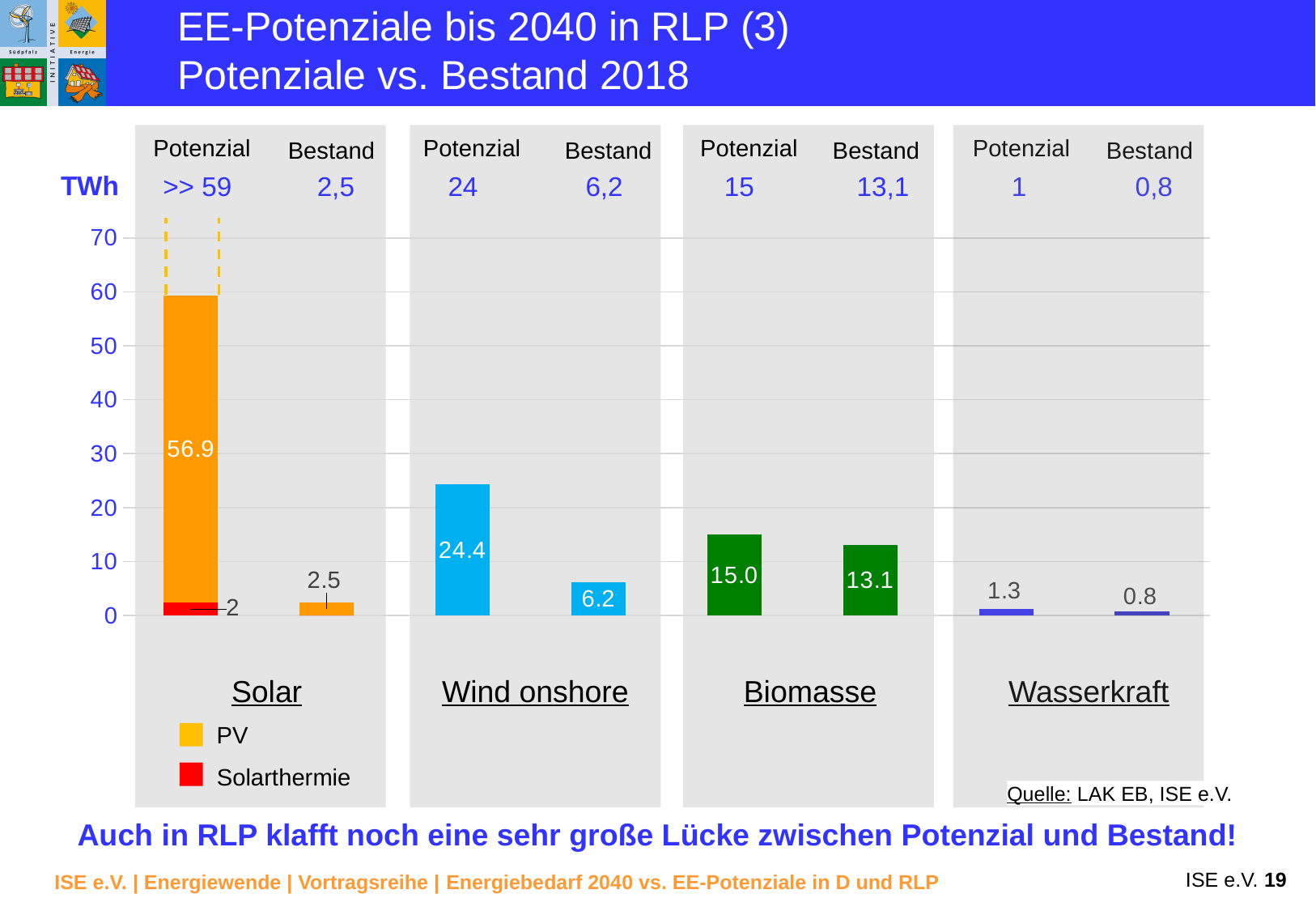
What is the difference between the Potenzial and Bestand data labels for Wind onshore? 18.2 What is the data label on the Potenzial bar for Wind onshore? 24.4 Which energy source has the highest Potenzial bar? Solar Which energy source has the lowest Bestand bar? Wasserkraft What is the data label on the PV segment of the Solar Potenzial bar? 56.9 Which is larger for Biomasse, the Potenzial bar or the Bestand bar? Potenzial What kind of chart is shown on the slide? bar chart What is the data label on the Solarthermie segment of the Solar Potenzial bar? 2 What is the data label on the Bestand bar for Biomasse? 13.1 How many energy source categories are shown in the chart? 4 What is the data label on the Bestand bar for Wasserkraft? 0.8 Is the Potenzial bar for Wind onshore greater or less than 20? greater